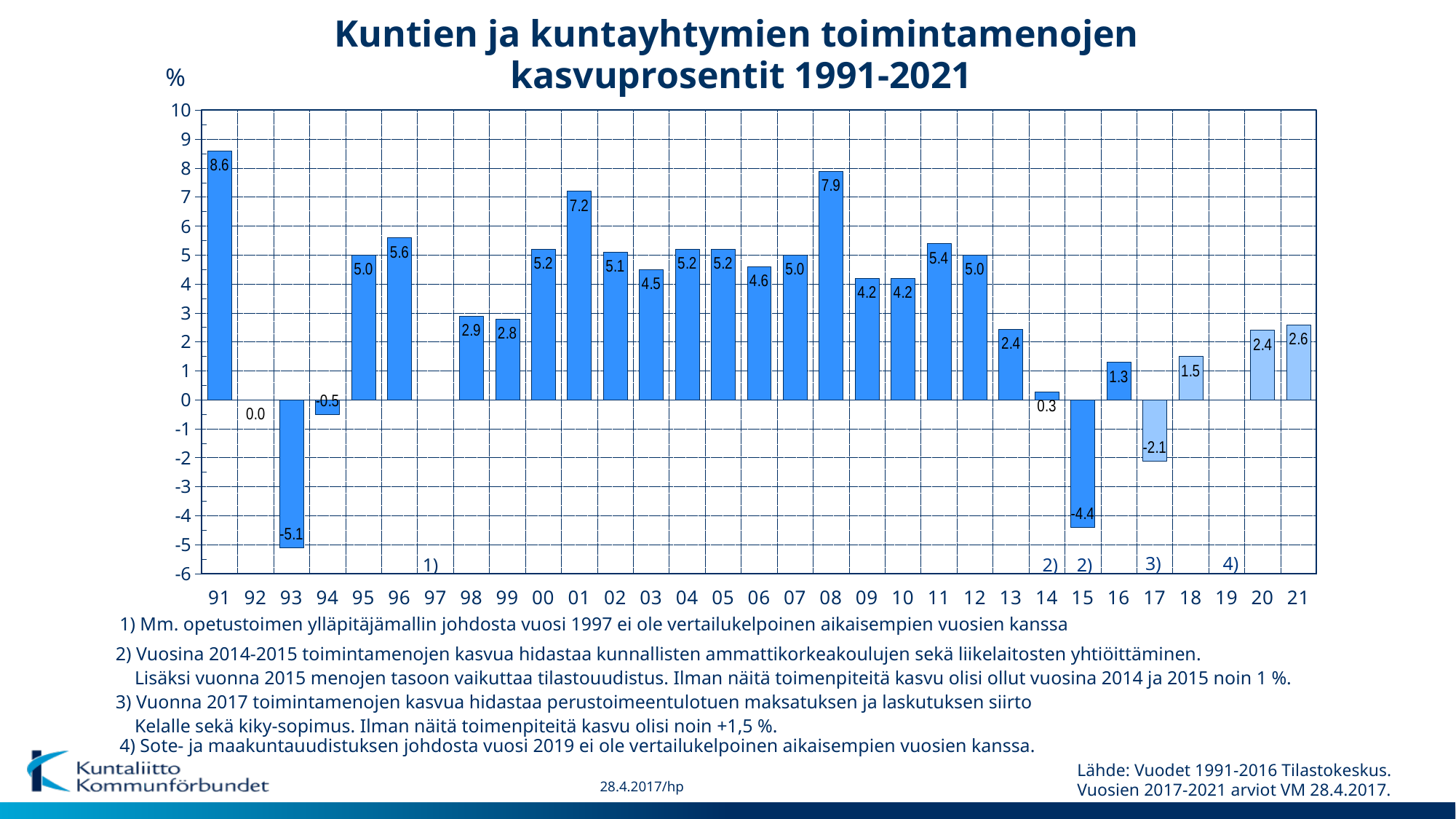
Which year has the highest value? 91 What kind of chart is this? bar chart Which is larger, the value for 1996 (96) or the value for 2011 (11)? 96 What is the value for 2015 (15)? -4.4 What is the value for 2021 (21)? 2.6 How many year labels are shown on the x axis? 31 What is the difference between the values for 2008 (08) and 2001 (01)? 0.7 Which year has the lowest value? 93 Do the values rise or fall from 2013 (13) to 2015 (15)? fall What is the value for 1991 (91)? 8.6 What unit is shown at the top of the y axis? % What is the value for 2008 (08)? 7.9